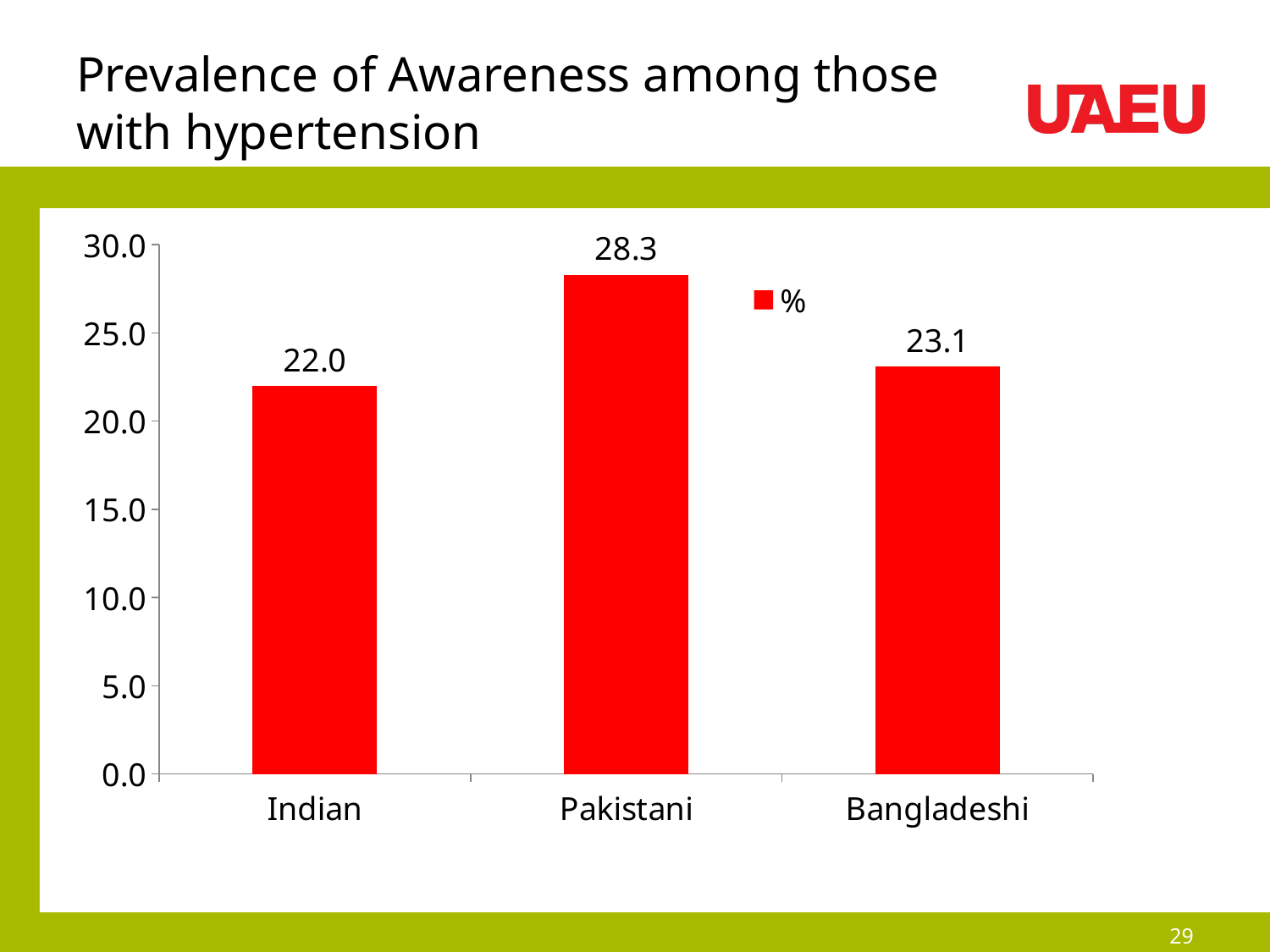
How many categories are shown on the x axis? 3 Which is larger, the value for Pakistani or the value for Bangladeshi? Pakistani What is the value for Pakistani? 28.3 Which category has the highest value? Pakistani What is the difference between the values for Bangladeshi and Indian? 1.1 What is the value for Bangladeshi? 23.1 What is the legend entry shown on the chart? % What is the difference between the values for Pakistani and Indian? 6.3 Which category has the lowest value? Indian Is the value for Pakistani greater or less than 25.0? greater What is the value for Indian? 22.0 What kind of chart is shown on the slide? bar chart